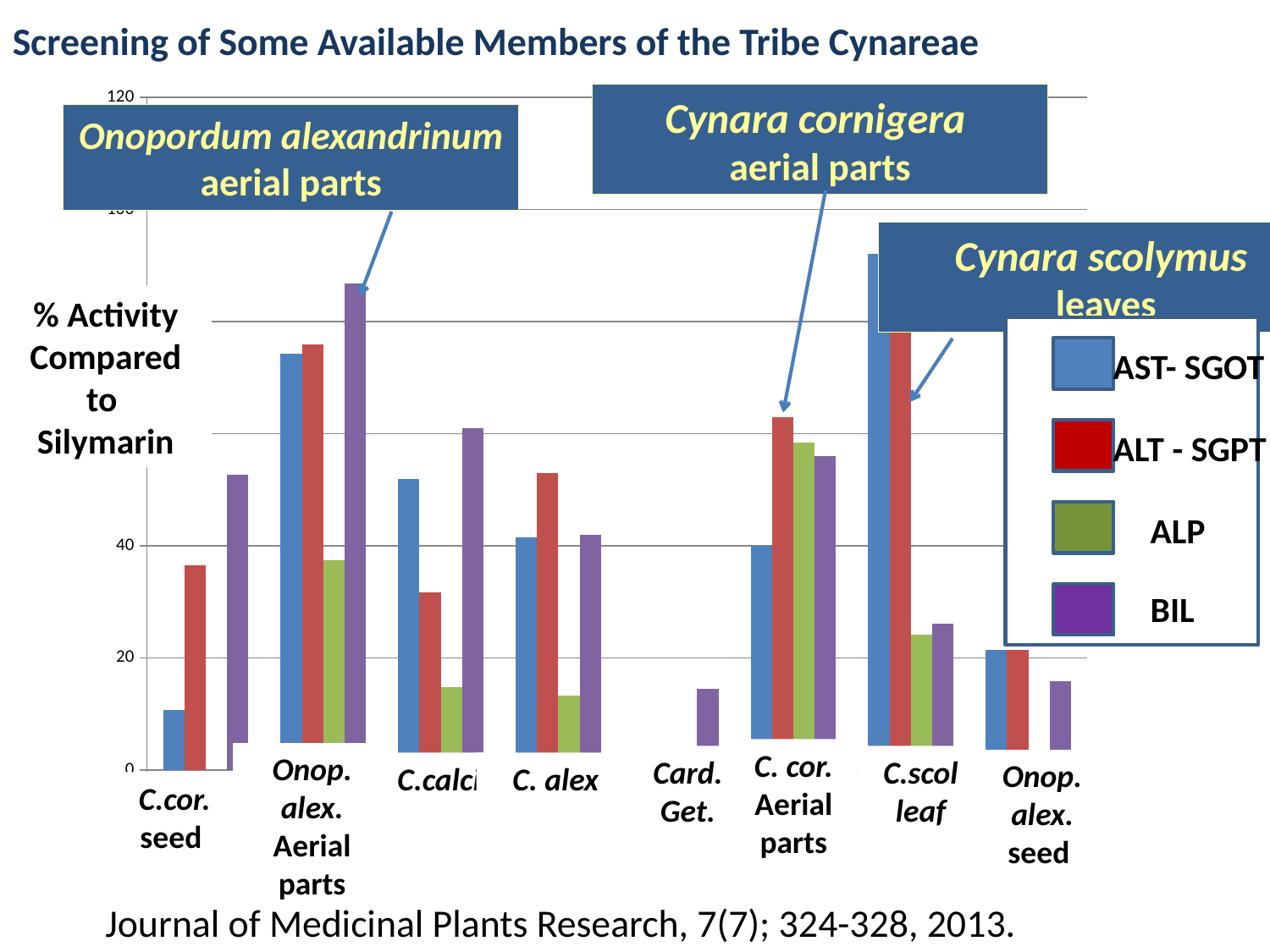
Which series are listed in the legend? AST- SGOT, ALT - SGPT, ALP, BIL Is the BIL value for Card. Get. greater or less than 20? less Is the BIL value for Onop. alex. Aerial parts greater or less than 40? greater What is the label on the vertical axis? % Activity Compared to Silymarin Is the ALT - SGPT value for C. alex greater or less than 40? greater How many plant sample categories are shown along the x axis? 8 What kind of chart is shown on the slide? bar chart Which category has the highest AST- SGOT value? C.scol leaf For C.cor. seed, which is larger: the BIL value or the ALT - SGPT value? BIL Which category has the highest BIL value? Onop. alex. Aerial parts How many series does the legend list? 4